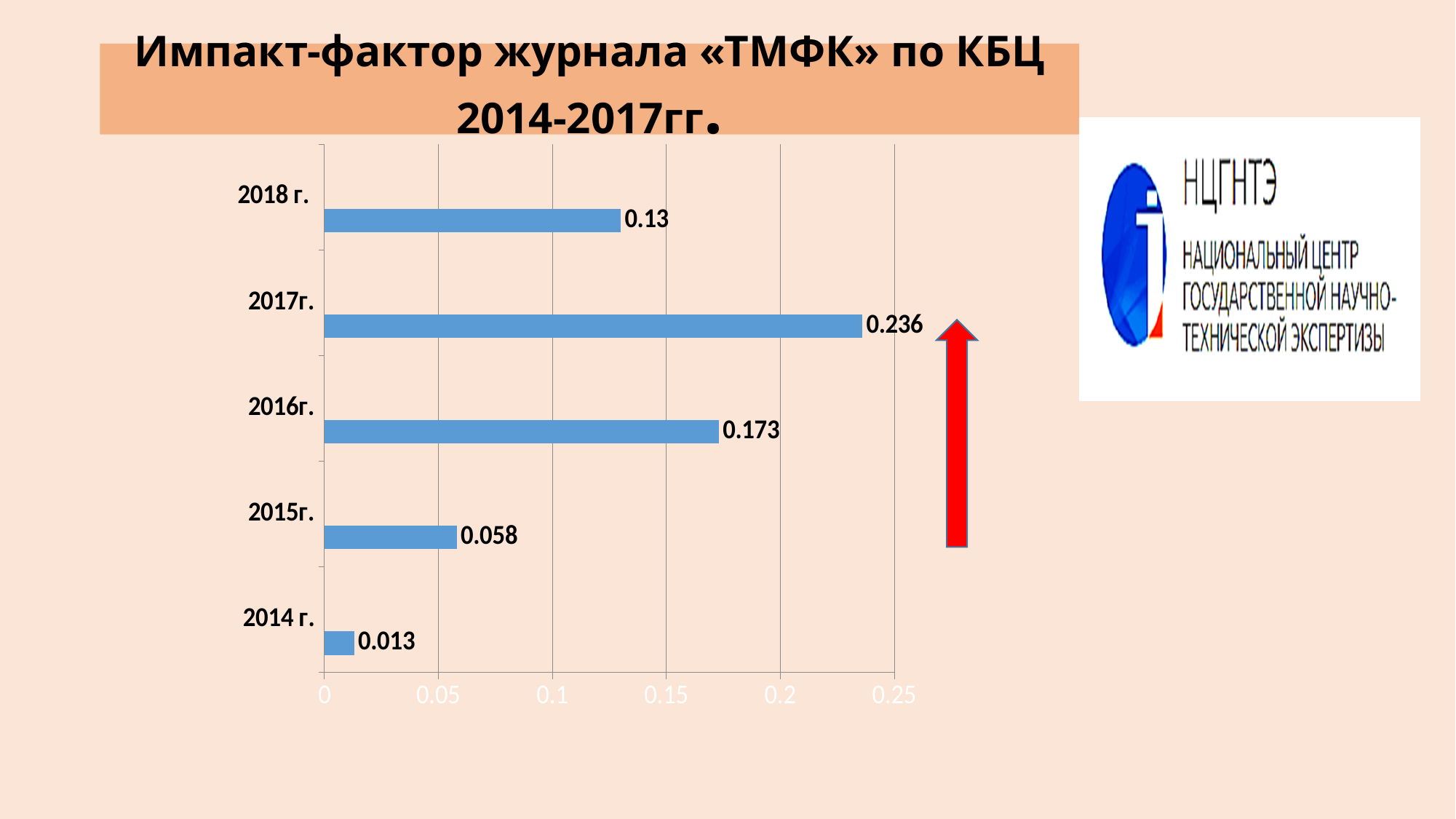
Which year has the highest value on the chart? 2017г. What is the value shown for 2018 г.? 0.13 What is the title of the chart on the slide? Импакт-фактор журнала «ТМФК» по КБЦ 2014-2017гг. Is the value for 2015г. greater or less than 0.05? greater Which year has the lowest value on the chart? 2014 г. What kind of chart is shown on the slide? bar chart What is the difference between the values for 2017г. and 2016г.? 0.063 What is the impact factor value shown for 2017г.? 0.236 Which is larger, the value for 2016г. or the value for 2018 г.? 2016г. How many years (categories) are shown on the chart? 5 What is the value shown for 2014 г.? 0.013 What is the difference between the values for 2015г. and 2014 г.? 0.045